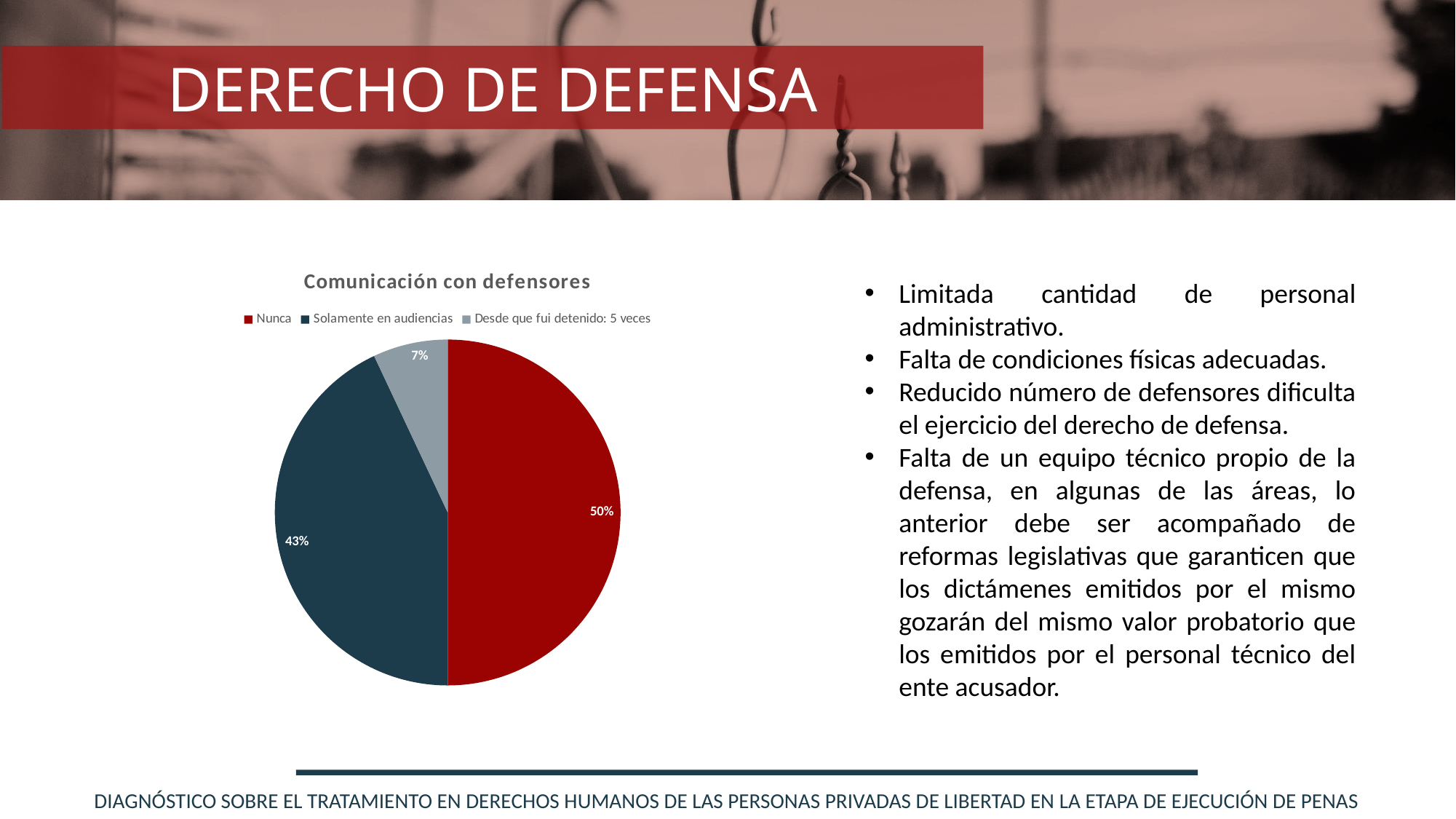
Which is larger: the share for "Solamente en audiencias" or the share for "Desde que fui detenido: 5 veces"? Solamente en audiencias Which category has the smallest share of the pie? Desde que fui detenido: 5 veces What type of chart is shown on the slide? Pie chart How many categories does the pie chart have? 3 Which category has the largest share of the pie? Nunca What percentage of the pie corresponds to "Solamente en audiencias"? 43% What is the title of the chart? Comunicación con defensores What colour is the "Nunca" slice? Dark red What is the difference in percentage points between "Nunca" and "Solamente en audiencias"? 7 What percentage of the pie corresponds to "Nunca"? 50% What percentage of the pie corresponds to "Desde que fui detenido: 5 veces"? 7% How many entries does the legend list? 3